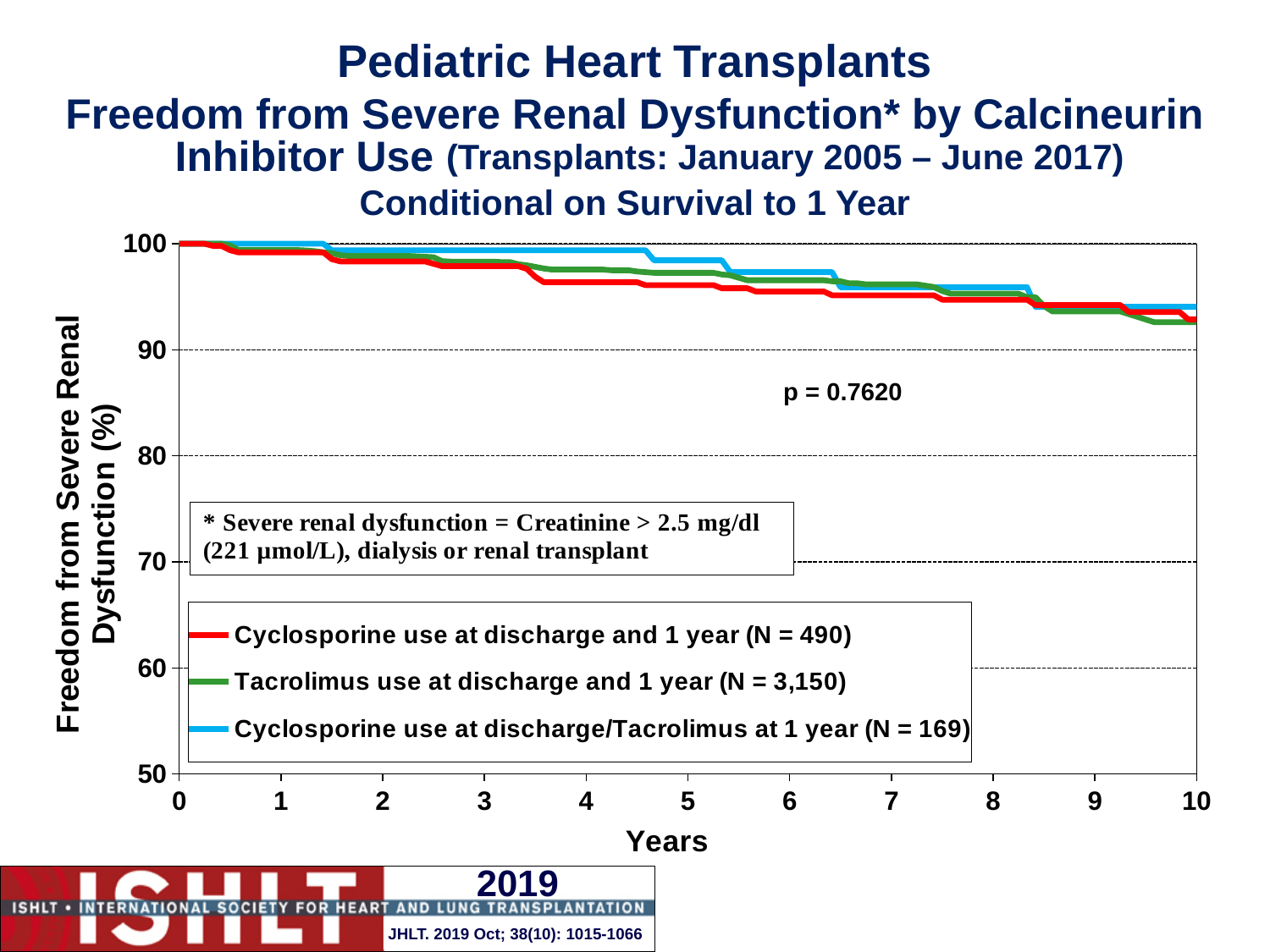
What colour is the line for Tacrolimus use at discharge and 1 year? Green What is the N for the Cyclosporine use at discharge and 1 year group? 490 What kind of chart is shown on the slide? Line chart How many series does the legend list? 3 Is the value for the Cyclosporine use at discharge and 1 year curve at 10 years greater or less than 90? greater What is the N for the Cyclosporine use at discharge/Tacrolimus at 1 year group? 169 What is the p-value shown on the chart? p = 0.7620 What is the label of the x axis? Years Do the freedom from severe renal dysfunction curves rise or fall as years increase? Fall What is the N for the Tacrolimus use at discharge and 1 year group? 3,150 Is the value for the Cyclosporine use at discharge/Tacrolimus at 1 year curve at 4 years greater or less than 90? greater At 4 years, which curve is higher: Cyclosporine use at discharge and 1 year or Cyclosporine use at discharge/Tacrolimus at 1 year? Cyclosporine use at discharge/Tacrolimus at 1 year